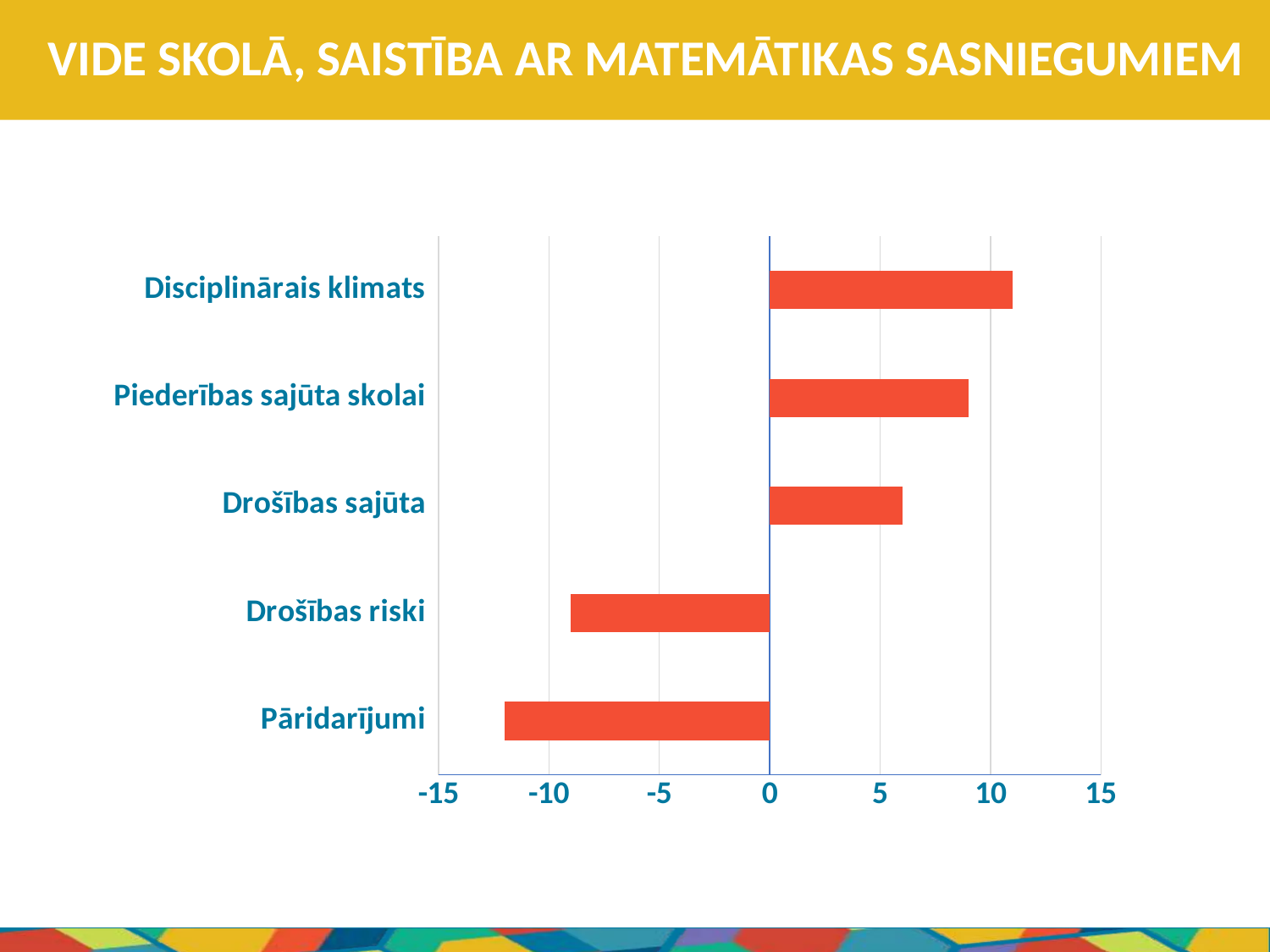
How many categories are plotted in the chart? 5 Which category has the highest value in the chart? Disciplinārais klimats Is the value for Piederības sajūta skolai greater or less than 10? less How many categories in the chart have negative values? 2 Is the value for Pāridarījumi greater or less than -10? less What kind of chart is shown on the slide? Bar chart Which is larger, the value for Drošības riski or the value for Pāridarījumi? Drošības riski Is the value for Disciplinārais klimats greater or less than 10? greater Which category has the lowest value in the chart? Pāridarījumi Which is larger, the value for Disciplinārais klimats or the value for Piederības sajūta skolai? Disciplinārais klimats